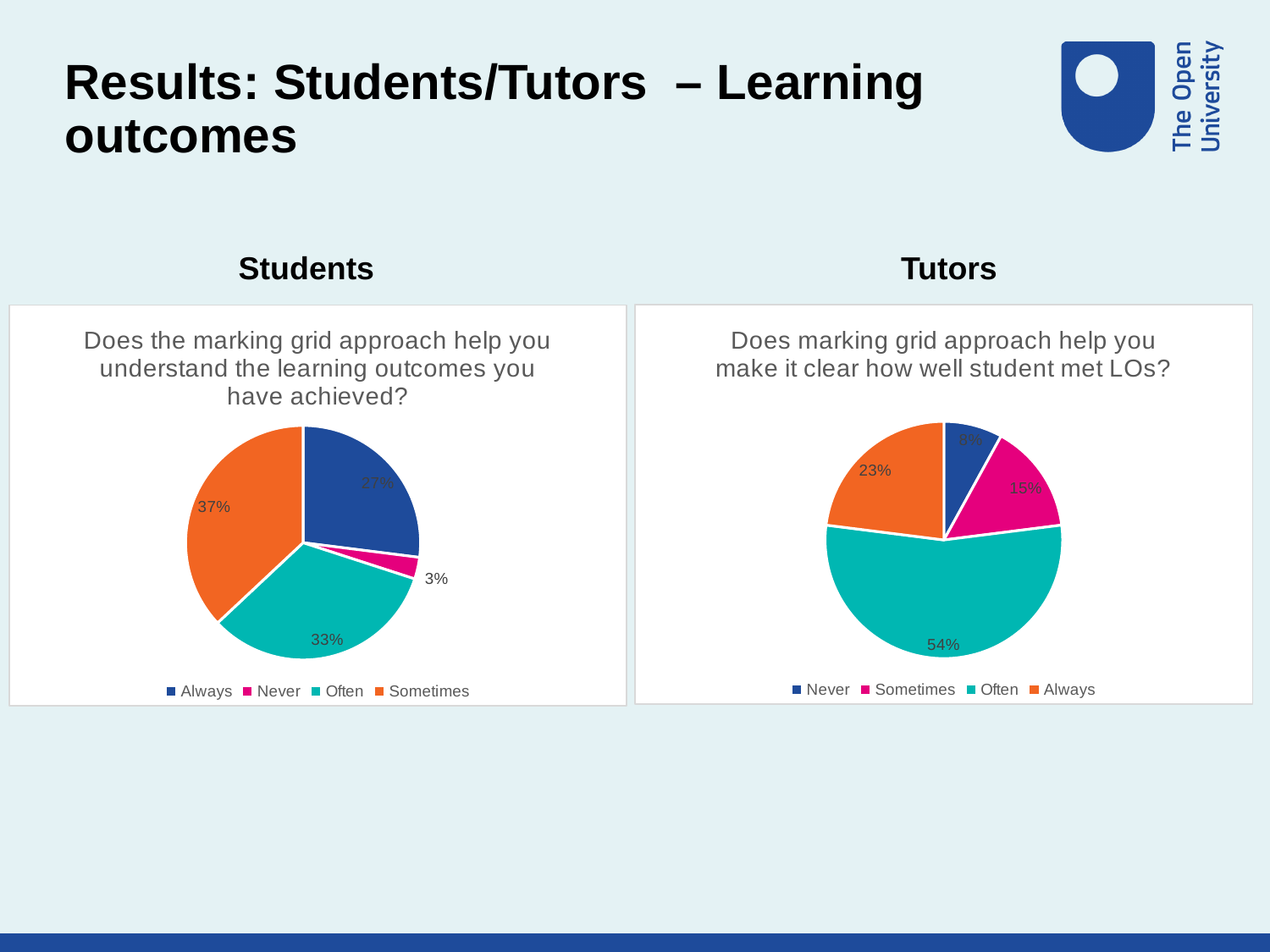
In the Tutors chart, what percentage of tutors answered "Often"? 54% In the Tutors chart, which colour represents "Often"? Teal In the Students chart, which is larger, the "Always" share or the "Often" share? Often In the Students chart, what percentage of students answered "Never"? 3% In the Students chart, what is the difference between the "Often" and "Always" shares? 6% In the Students chart, what percentage of students answered "Sometimes"? 37% In the Students chart, which response has the largest share? Sometimes What type of chart is used for the Students results? Pie chart In the Tutors chart, which response has the smallest share? Never How many slices does the Tutors pie chart have? 4 In the Tutors chart, what percentage of tutors answered "Always"? 23% In the Tutors chart, what is the difference between the "Often" and "Sometimes" shares? 39%